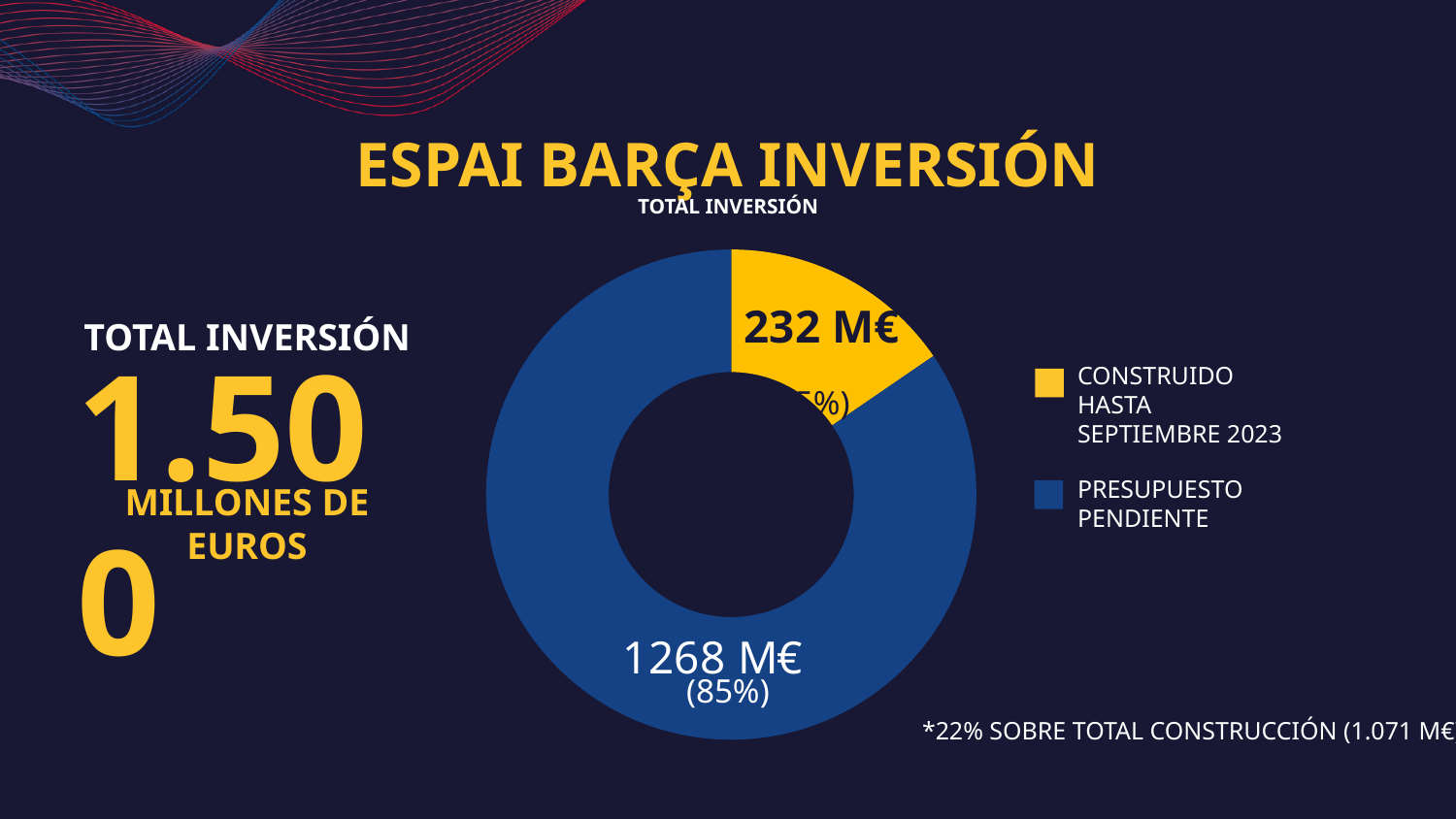
How many slices does the doughnut chart have? 2 What is the value for CONSTRUIDO HASTA SEPTIEMBRE 2023? 232 M€ Which slice is the smallest? CONSTRUIDO HASTA SEPTIEMBRE 2023 Which slice is the largest? PRESUPUESTO PENDIENTE What share of the doughnut does PRESUPUESTO PENDIENTE represent? 85% What is the chart's title? TOTAL INVERSIÓN How many entries does the legend list? 2 What is the value for PRESUPUESTO PENDIENTE? 1268 M€ Which is larger, CONSTRUIDO HASTA SEPTIEMBRE 2023 or PRESUPUESTO PENDIENTE? PRESUPUESTO PENDIENTE What is the difference between PRESUPUESTO PENDIENTE and CONSTRUIDO HASTA SEPTIEMBRE 2023? 1036 M€ What type of chart is shown on the slide? Doughnut chart Which colour represents CONSTRUIDO HASTA SEPTIEMBRE 2023 in the chart? Yellow